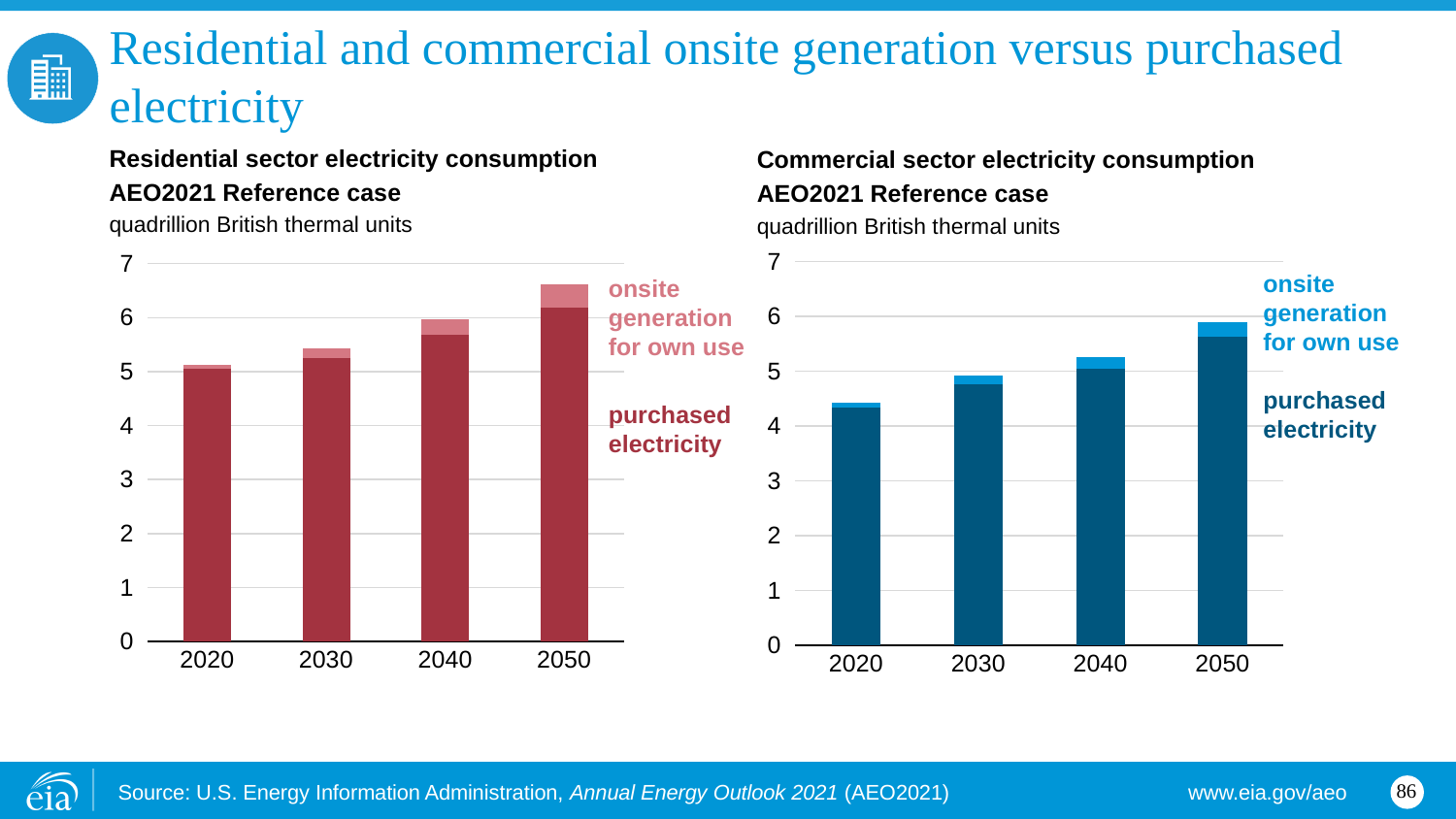
In the Residential sector electricity consumption chart, does total electricity consumption rise or fall from 2020 to 2050? rise In the Commercial sector electricity consumption chart, is the total value for 2020 greater or less than 5? less In the Commercial sector electricity consumption chart, is the total value for 2040 greater or less than 5? greater How many years are shown on the x axis of the Commercial sector electricity consumption chart? 4 What unit is used on the y axis of the Commercial sector electricity consumption chart? quadrillion British thermal units What type of chart is the Residential sector electricity consumption chart? stacked bar chart How many series are shown in the Residential sector electricity consumption chart? 2 Which series is shown in the lighter colour at the top of each bar in the Commercial sector electricity consumption chart? onsite generation for own use In the Commercial sector electricity consumption chart, which year has the highest total electricity consumption? 2050 In the Residential sector electricity consumption chart, which year has the lowest total electricity consumption? 2020 In the Residential sector electricity consumption chart, which is larger in 2050: purchased electricity or onsite generation for own use? purchased electricity In the Residential sector electricity consumption chart, is the total value for 2050 greater or less than 6? greater